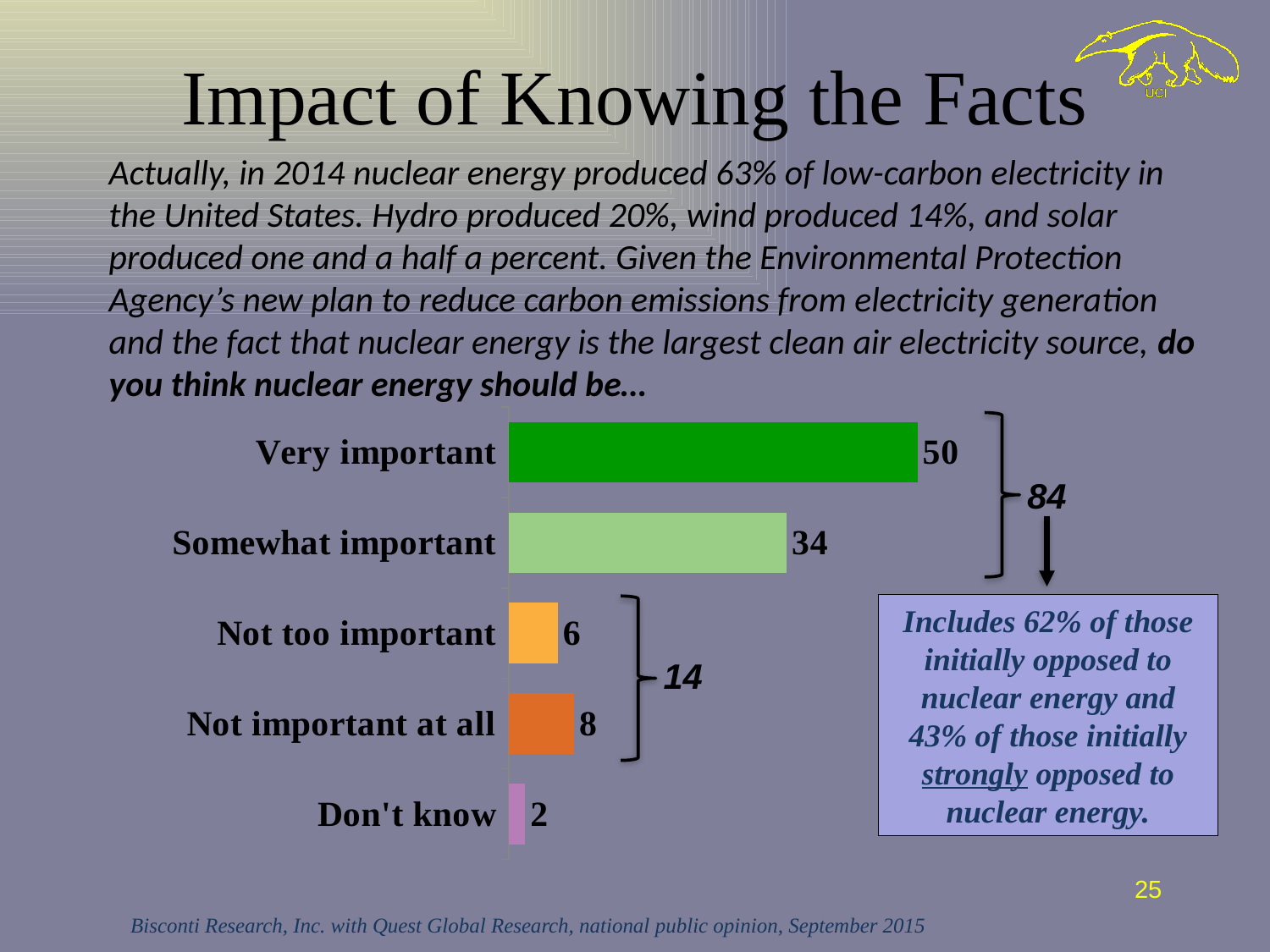
What is the value for "Not too important"? 6 What is the value for "Not important at all"? 8 How many categories are shown in the chart? 5 Which is larger, the value for "Not too important" or "Not important at all"? Not important at all What is the value for "Somewhat important"? 34 What kind of chart is shown on the slide? Bar chart What is the difference between the values for "Very important" and "Somewhat important"? 16 Which category has the lowest value? Don't know What is the value for "Very important"? 50 Which category has the highest value? Very important What combined value is shown by the bracket grouping "Not too important" and "Not important at all"? 14 What is the value for "Don't know"? 2